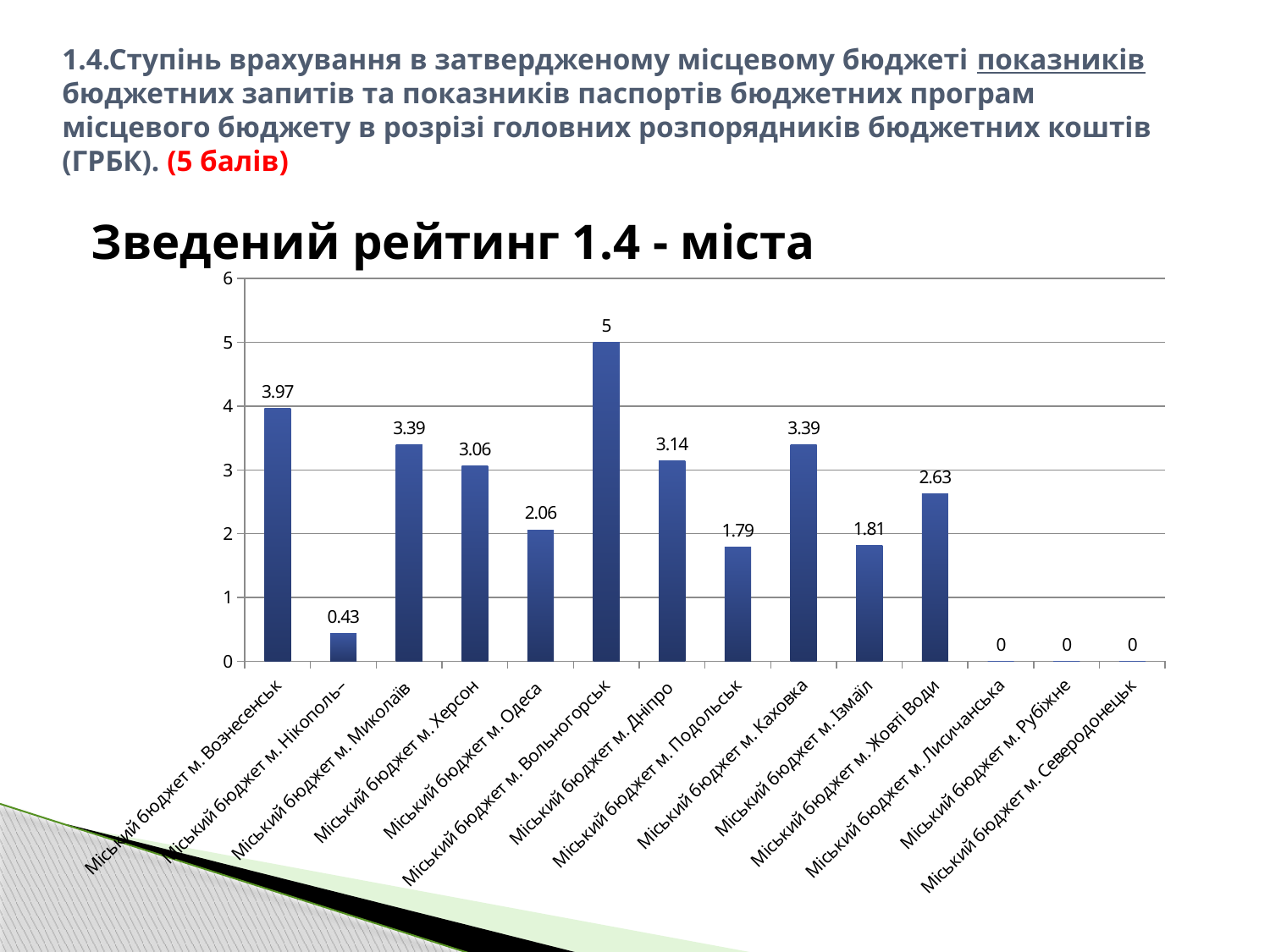
How many city budgets have a value of 0 in the chart? 3 How many city budgets are shown in the chart? 14 What is the value for Міський бюджет м. Вознесенськ in the chart 'Зведений рейтинг 1.4 - міста'? 3.97 What is the value for Міський бюджет м. Жовті Води? 2.63 Is the value for Міський бюджет м. Одеса greater or less than 3? less What is the value for Міський бюджет м. Нікополь? 0.43 Which is larger, the value for Міський бюджет м. Херсон or for Міський бюджет м. Дніпро? Міський бюджет м. Дніпро What is the value for Міський бюджет м. Подольськ? 1.79 What is the title of the chart on the slide? Зведений рейтинг 1.4 - міста What is the difference between the values for Міський бюджет м. Вольногорськ and Міський бюджет м. Вознесенськ? 1.03 What kind of chart is shown on the slide? bar chart Which city budget has the highest value in the chart? Міський бюджет м. Вольногорськ